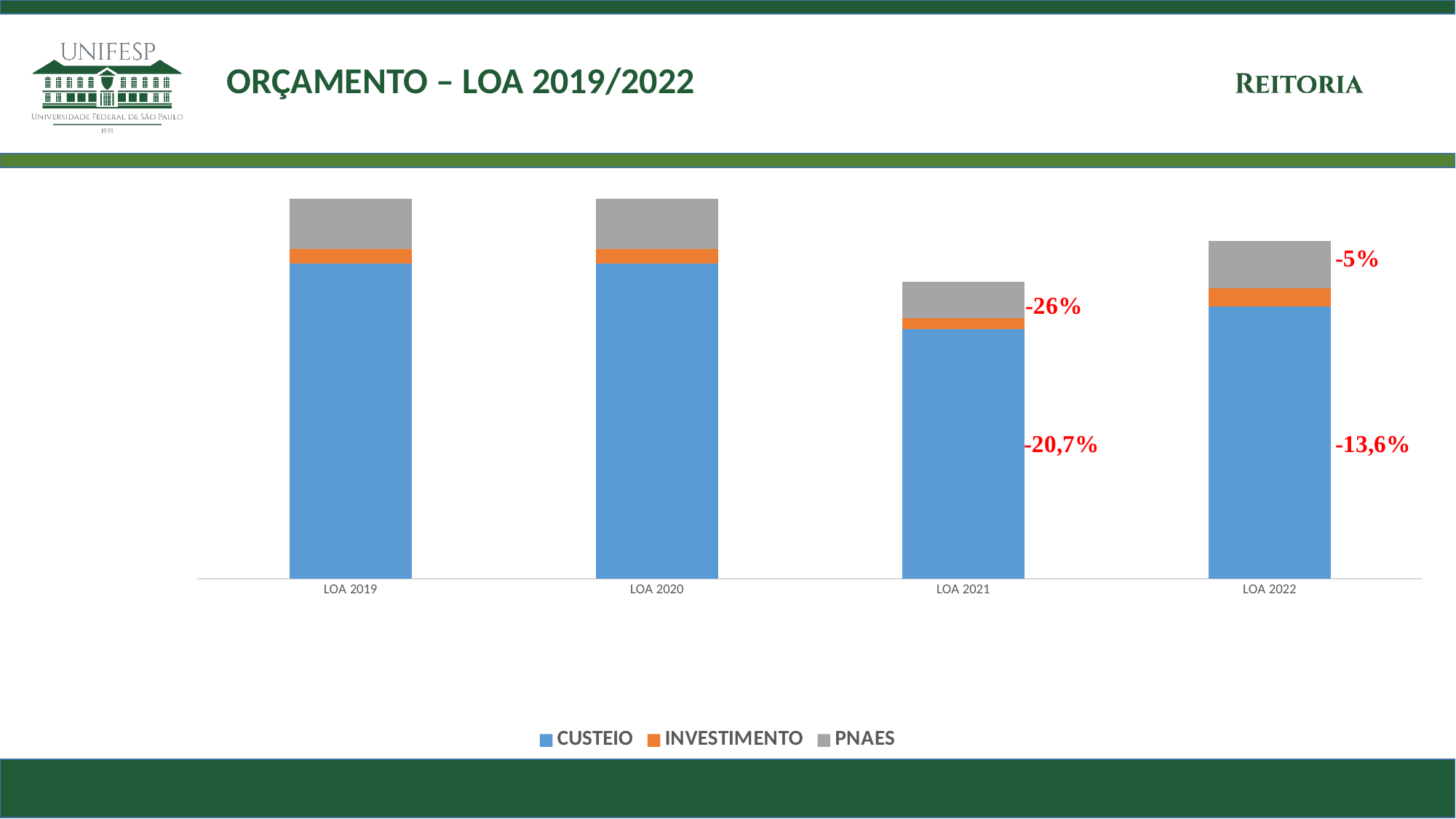
Which category has the lowest total bar? LOA 2021 Which series forms the largest segment of each bar? CUSTEIO What red percentage annotation is shown next to the CUSTEIO segment of the LOA 2021 bar? -20,7% How many series does the legend list? 3 Which CUSTEIO segment is taller, LOA 2019 or LOA 2021? LOA 2019 Which series are listed in the legend? CUSTEIO, INVESTIMENTO, PNAES Which total bar is taller, LOA 2020 or LOA 2021? LOA 2020 What is the title of the slide containing the chart? ORÇAMENTO – LOA 2019/2022 Which total bar is taller, LOA 2021 or LOA 2022? LOA 2022 Which series forms the smallest segment of each bar? INVESTIMENTO What kind of chart is shown on the slide? Stacked bar chart How many categories (LOA years) are shown on the x axis? 4